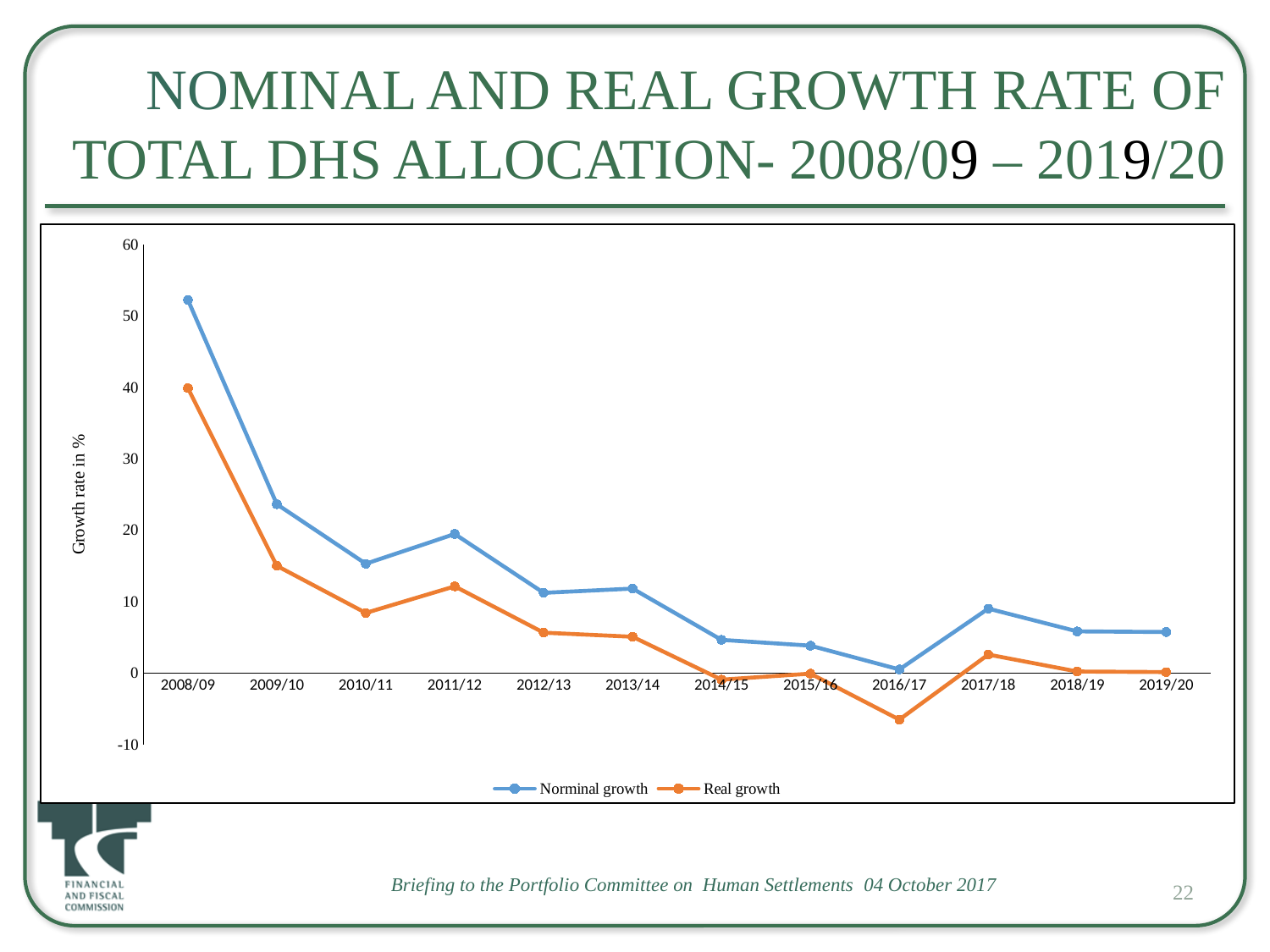
In which year is the Norminal growth value highest? 2008/09 How many financial years are plotted along the x axis? 12 How many series does the legend list? 2 Is the Norminal growth value for 2008/09 greater or less than 50? greater Which is larger in 2011/12, Norminal growth or Real growth? Norminal growth Is the Norminal growth value for 2009/10 greater or less than 20? greater Is the Real growth value for 2016/17 greater or less than 0? less In which year is the Real growth value lowest? 2016/17 What kind of chart is shown on the slide? line chart What is the label on the vertical axis? Growth rate in % Does the Norminal growth line generally rise or fall from 2008/09 to 2016/17? fall